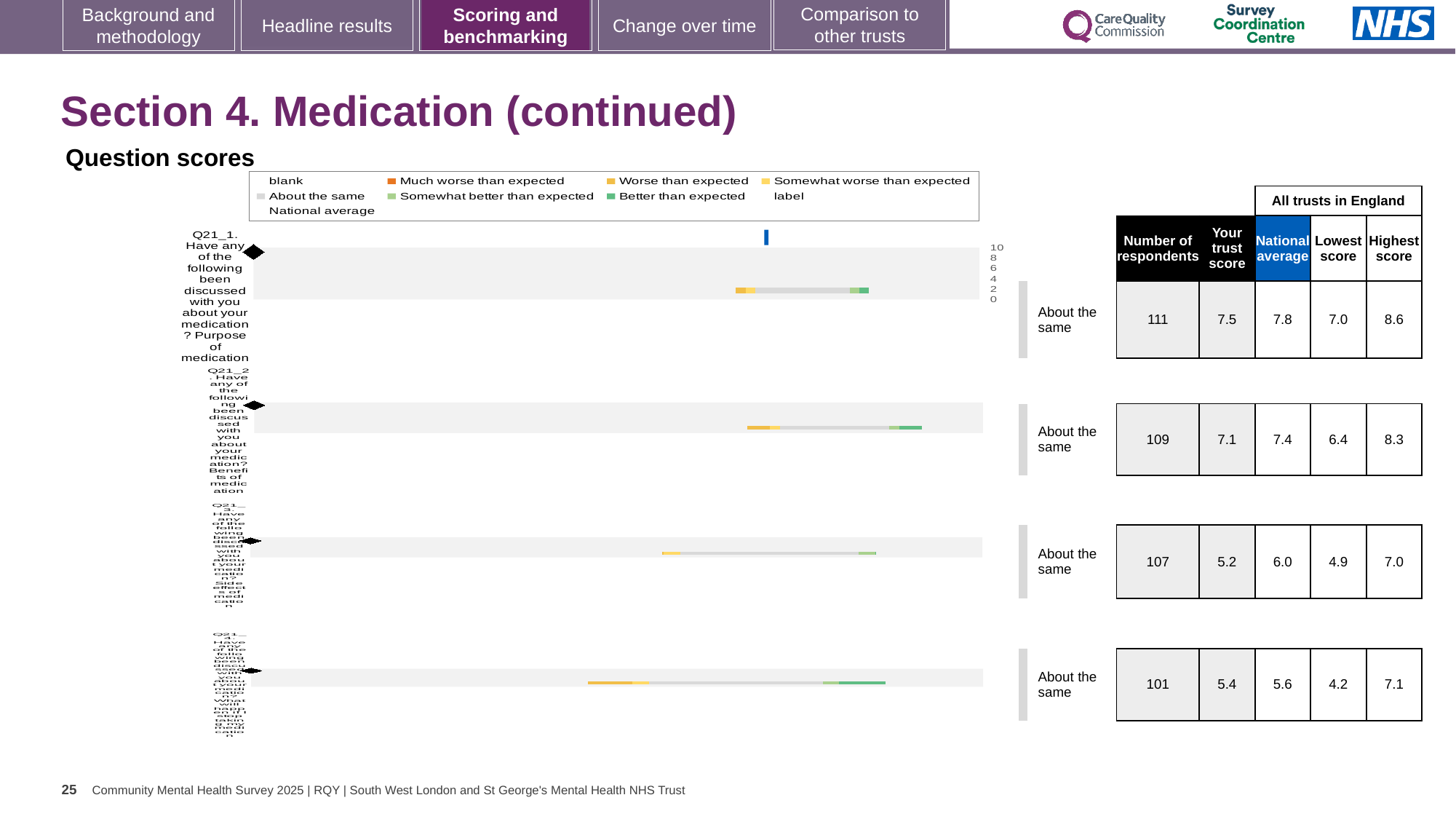
What benchmark category is shown for all four question rows? About the same What is the difference between the national average and the trust score for Q21_1? 0.3 Which question row has the lowest 'Your trust score'? The third row (Q21_3) For Q21_2, which is larger: the trust score or the national average? National average What is the highest score across all trusts in England for the third question row? 7.0 How many question rows are plotted in the chart? 4 Which question row has the highest number of respondents? Q21_1 (Purpose of medication) What is the number of respondents for Q21_1 (Purpose of medication)? 111 What is the lowest score across all trusts in England for the fourth question row? 4.2 What is the national average for Q21_2 (Benefits of medication)? 7.4 What is the 'Your trust score' value for Q21_1 (Purpose of medication)? 7.5 What kind of chart is shown under 'Question scores'? bar chart